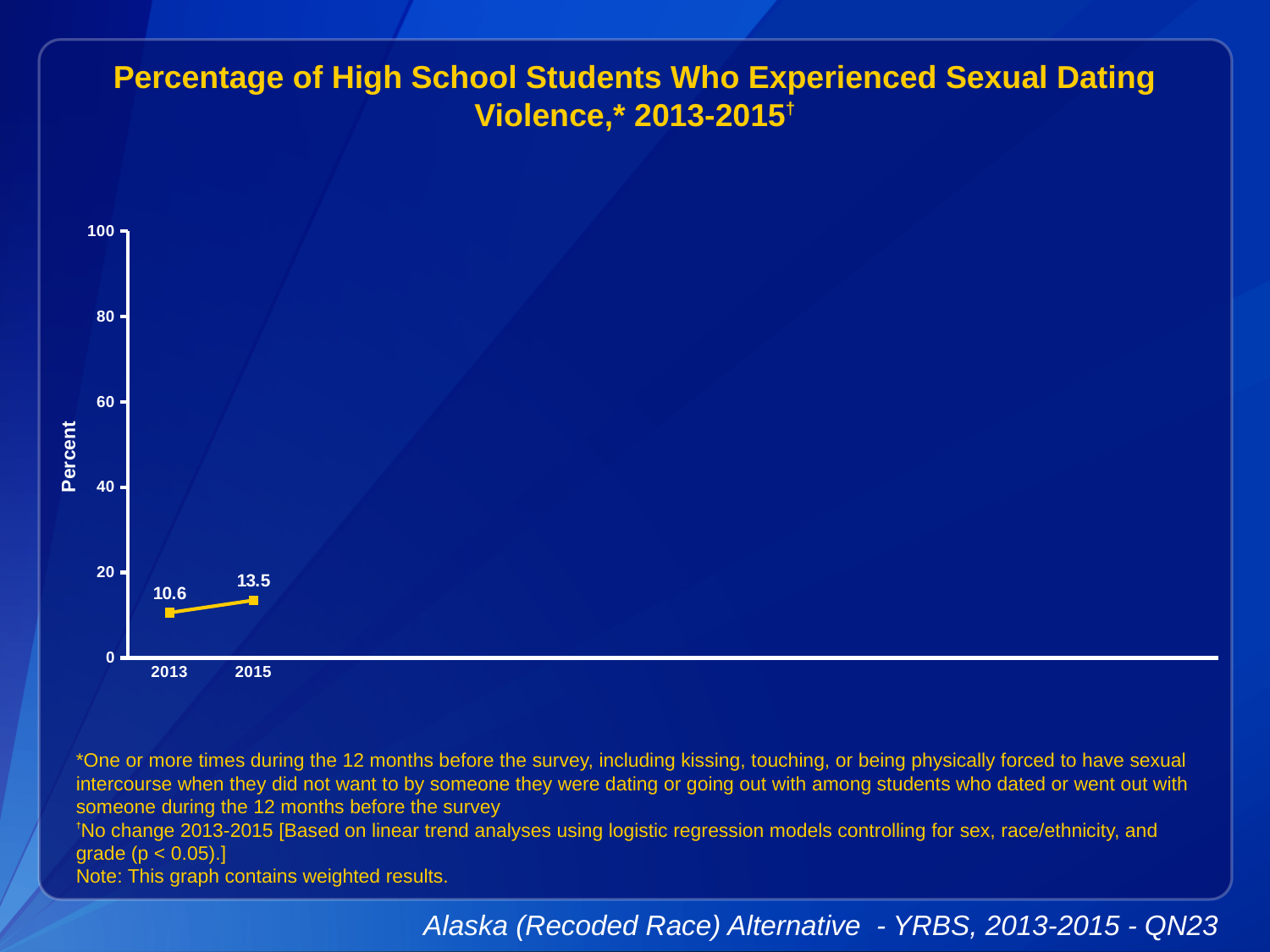
What is the label of the y axis? Percent Which year has the higher value? 2015 What is the maximum value shown on the y axis? 100 What is the difference between the 2015 and 2013 values? 2.9 What is the value for 2015? 13.5 Is the value for 2015 greater or less than 20? less Which year has the lower value? 2013 What kind of chart is shown on the slide? line chart Do the values rise or fall from 2013 to 2015? rise How many data points are plotted on the chart? 2 What is the value for 2013? 10.6